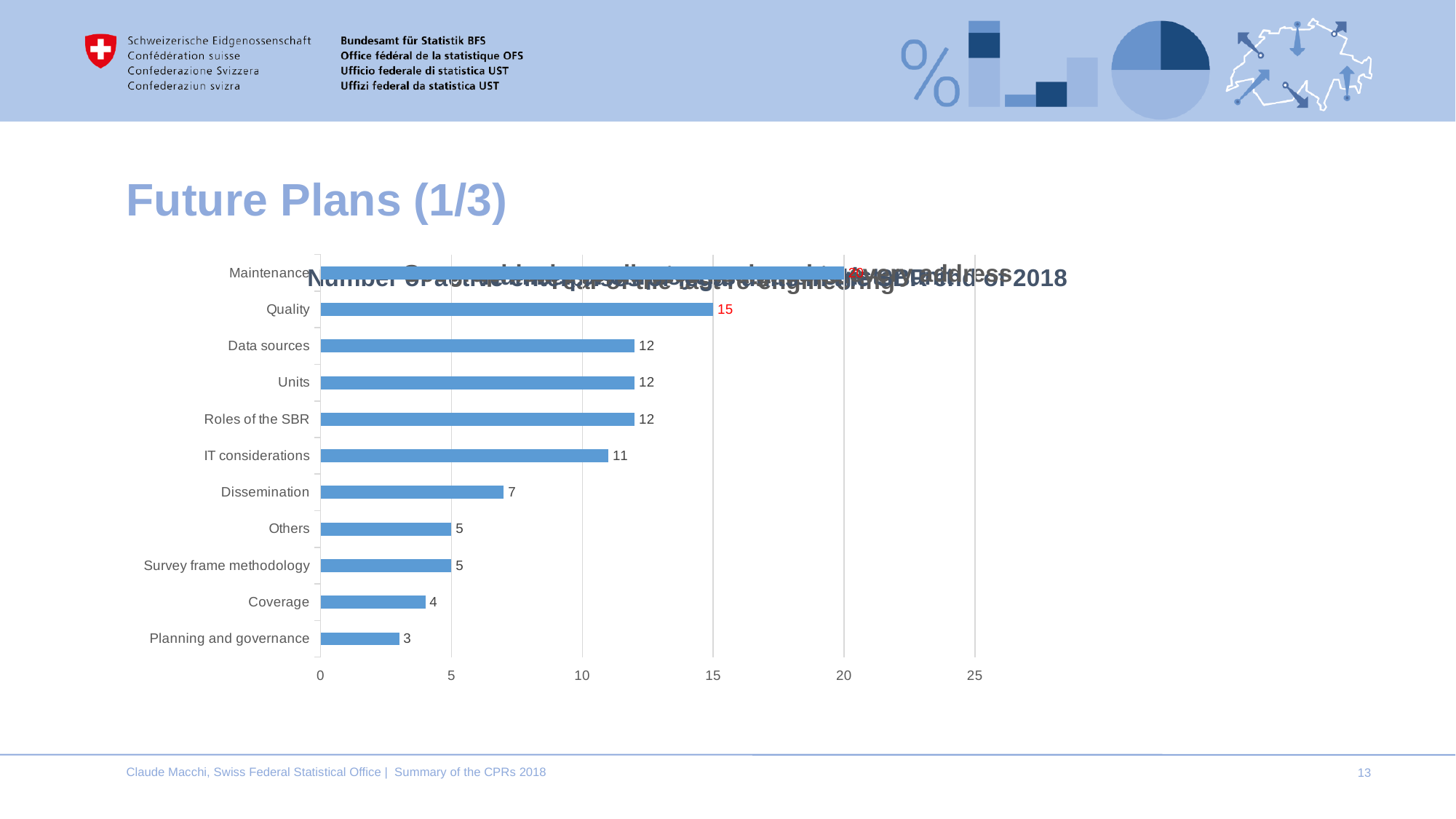
Which category has the longest bar? Maintenance What kind of chart is shown on the slide? Bar chart What is the value for Coverage? 4 How many categories are shown on the chart? 11 Which is larger, the value for Dissemination or the value for Others? Dissemination What is the value for Quality? 15 Is the value for Maintenance greater or less than 15? greater What is the value for IT considerations? 11 What is the difference between the values for Survey frame methodology and Planning and governance? 2 What is the difference between the values for Quality and Data sources? 3 Which category has the lowest value? Planning and governance What is the value for Dissemination? 7